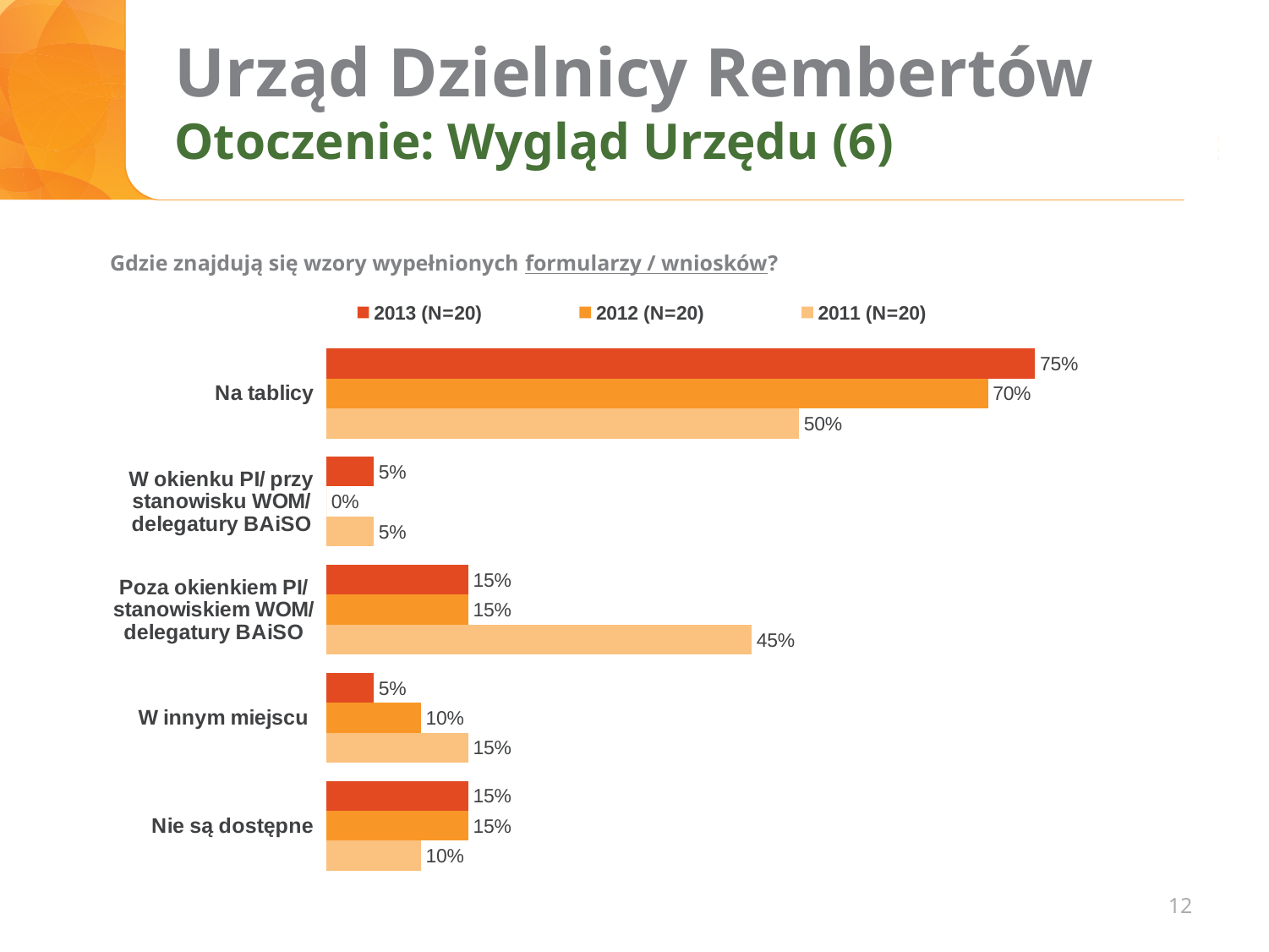
Which is larger for "Nie są dostępne": the 2013 (N=20) value or the 2011 (N=20) value? 2013 (N=20) How many series does the legend list? 3 Which category has the lowest value in the 2012 (N=20) series? W okienku PI/ przy stanowisku WOM/ delegatury BAiSO What kind of chart is shown on the slide? Bar chart What is the value for "Na tablicy" in the 2013 (N=20) series? 75% What question is the chart answering, as stated above it? Gdzie znajdują się wzory wypełnionych formularzy / wniosków? What is the value for "W innym miejscu" in the 2012 (N=20) series? 10% What is the value for "Poza okienkiem PI/ stanowiskiem WOM/ delegatury BAiSO" in the 2011 (N=20) series? 45% Which category has the highest value in the 2011 (N=20) series? Na tablicy How many categories are shown on the chart? 5 What is the value for "W okienku PI/ przy stanowisku WOM/ delegatury BAiSO" in the 2012 (N=20) series? 0% What is the difference between the 2013 (N=20) and 2011 (N=20) values for "Na tablicy"? 25%